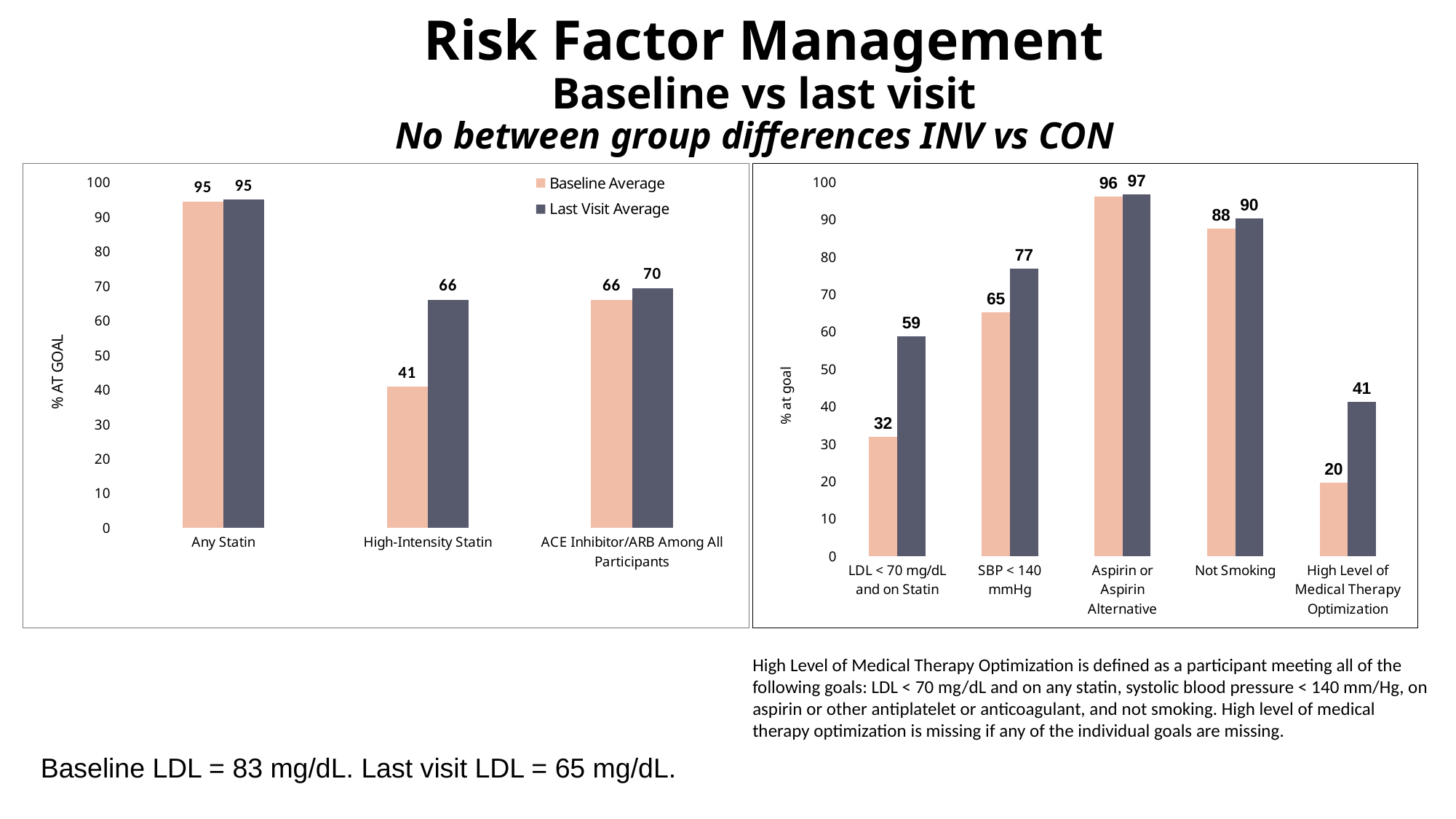
In the right chart, which is larger for SBP < 140 mmHg: the Baseline Average or the Last Visit Average? Last Visit Average How many series does the legend of the left chart list? 2 In the right chart, what is the difference between the Last Visit Average and Baseline Average for LDL < 70 mg/dL and on Statin? 27 How many categories are shown on the x axis of the right chart? 5 In the right chart, which category has the highest Last Visit Average value? Aspirin or Aspirin Alternative In the left chart, what is the Baseline Average value for High-Intensity Statin? 41 In the left chart, what is the difference between the Last Visit Average and Baseline Average for High-Intensity Statin? 25 In the left chart, what is the Last Visit Average value for ACE Inhibitor/ARB Among All Participants? 70 In the right chart, which category has the lowest Baseline Average value? High Level of Medical Therapy Optimization What type of chart is the left chart? Bar chart In the right chart, what is the Baseline Average value for LDL < 70 mg/dL and on Statin? 32 In the right chart, what is the Last Visit Average value for High Level of Medical Therapy Optimization? 41